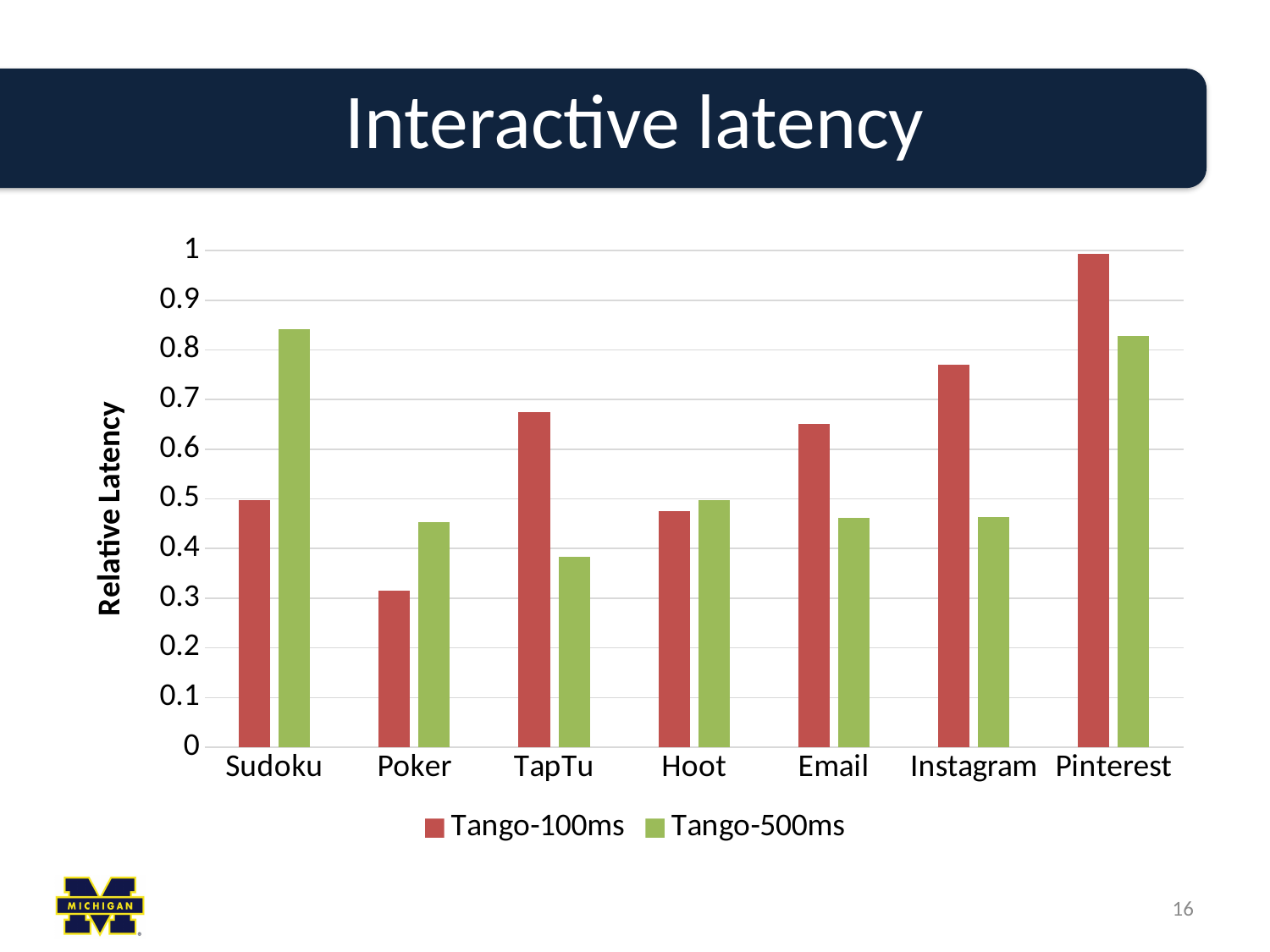
Is the Tango-500ms value for Sudoku greater or less than 0.8? greater Which app has the lowest Tango-100ms relative latency? Poker For Sudoku, which series has the larger relative latency, Tango-100ms or Tango-500ms? Tango-500ms What kind of chart is shown on the slide? bar chart Which app has the highest Tango-100ms relative latency? Pinterest Is the Tango-100ms value for Poker greater or less than 0.4? less How many series does the legend list? 2 Which app has the lowest Tango-500ms relative latency? TapTu Is the Tango-100ms value for Instagram greater or less than 0.7? greater What is the label of the y axis? Relative Latency How many app categories are shown on the x axis? 7